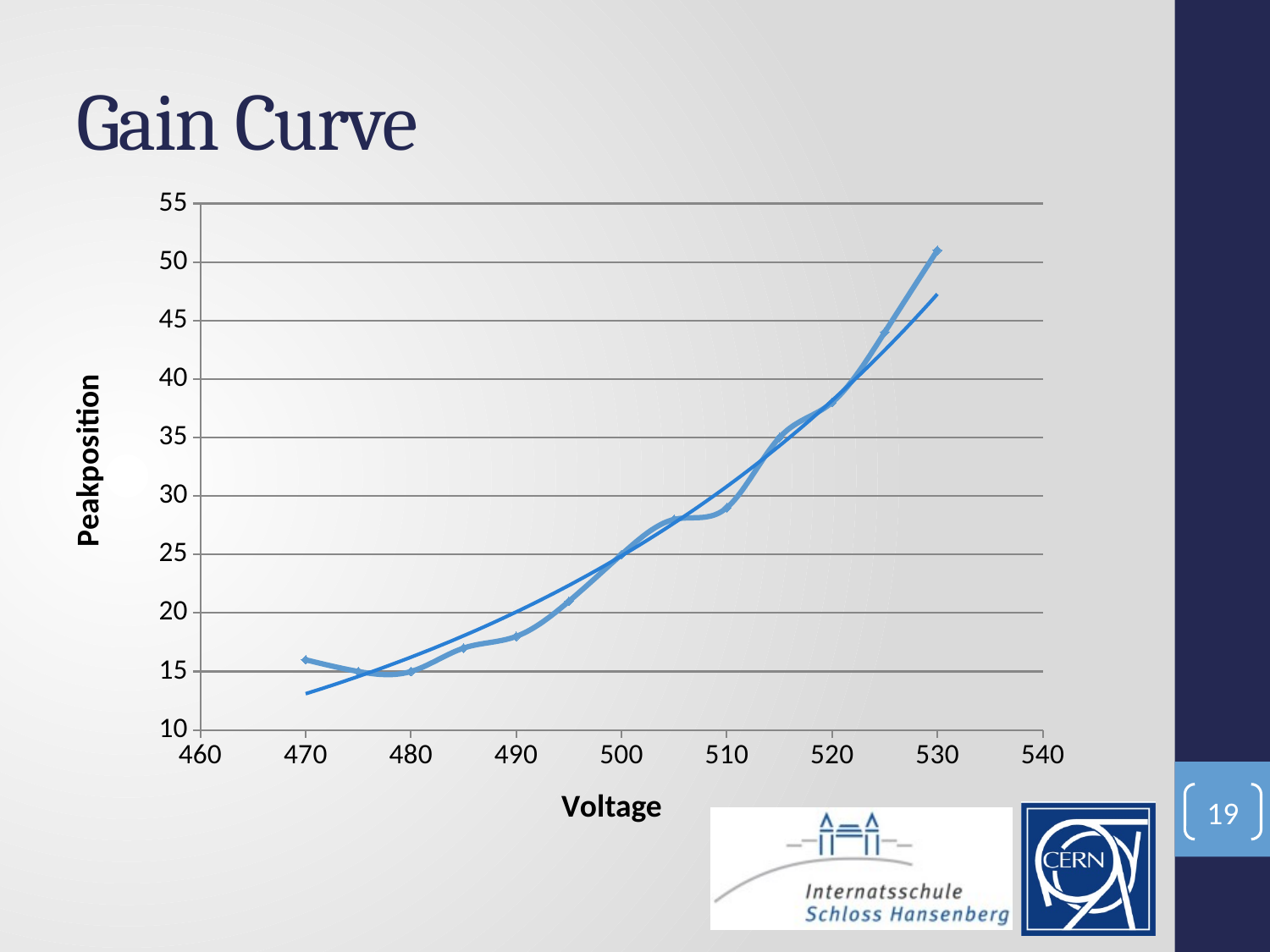
Which has the larger Peakposition, Voltage 470 or Voltage 530? 530 Is the Peakposition at Voltage 490 greater or less than 20? less What is the title of the chart? Gain Curve Is the Peakposition at Voltage 510 greater or less than 30? less What kind of chart is shown on the slide? line chart Which has the larger Peakposition, Voltage 500 or Voltage 520? 520 What is the label of the y axis? Peakposition At which Voltage is the Peakposition highest? 530 Do the Peakposition values generally rise or fall as Voltage increases? rise Is the Peakposition at Voltage 515 greater or less than 30? greater